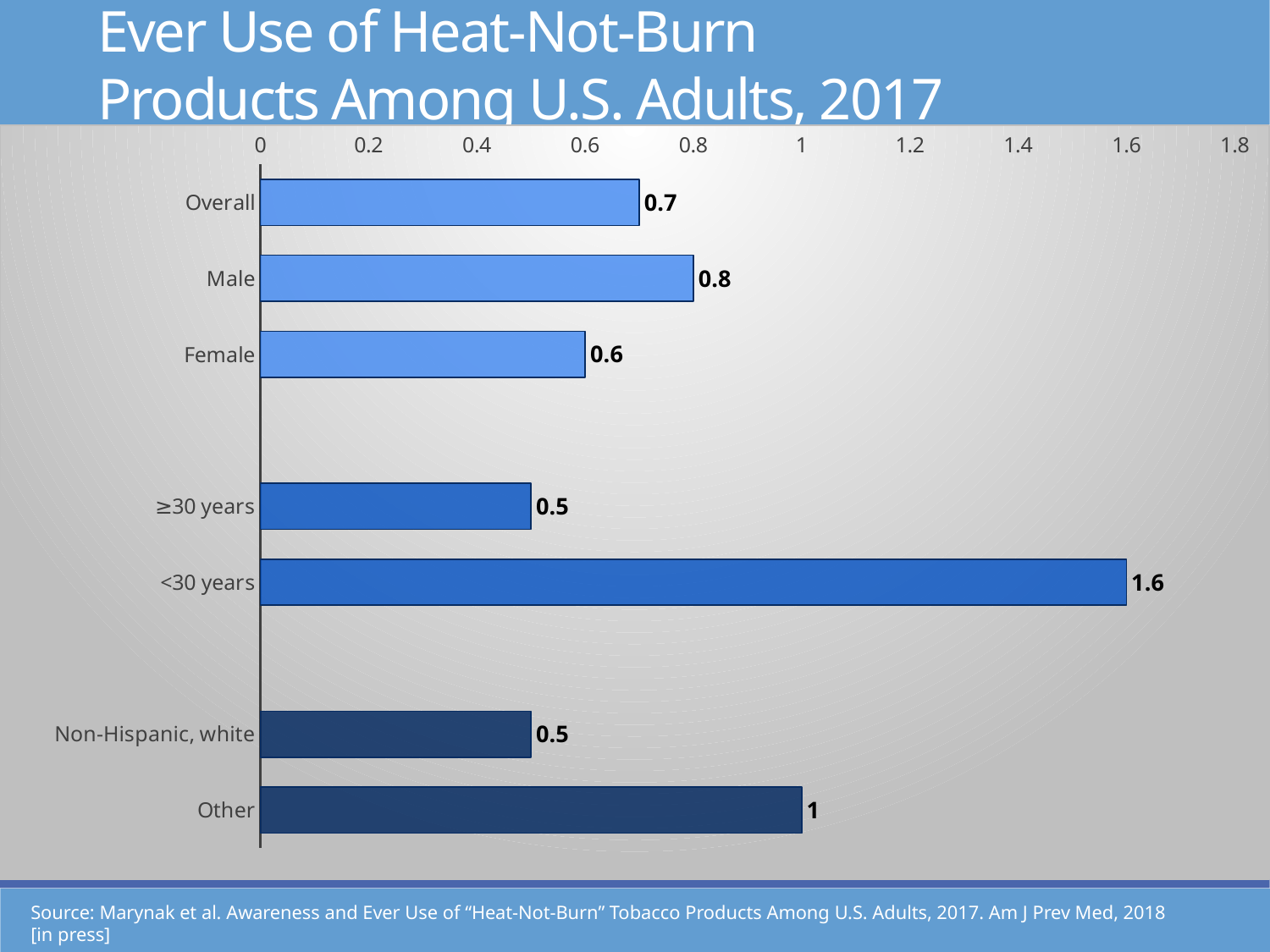
What is the value for Overall? 0.7 What is the difference between the values for Male and Female? 0.2 Is the value for <30 years greater or less than 1.4? greater What kind of chart is shown on the slide? bar chart Which is larger, the value for Other or the value for Non-Hispanic, white? Other Which category has the highest value? <30 years What is the difference between the values for <30 years and ≥30 years? 1.1 How many bars are plotted on the chart? 7 What is the value for Male? 0.8 What is the value for <30 years? 1.6 What is the value for Other? 1 What is the title of the chart? Ever Use of Heat-Not-Burn Products Among U.S. Adults, 2017